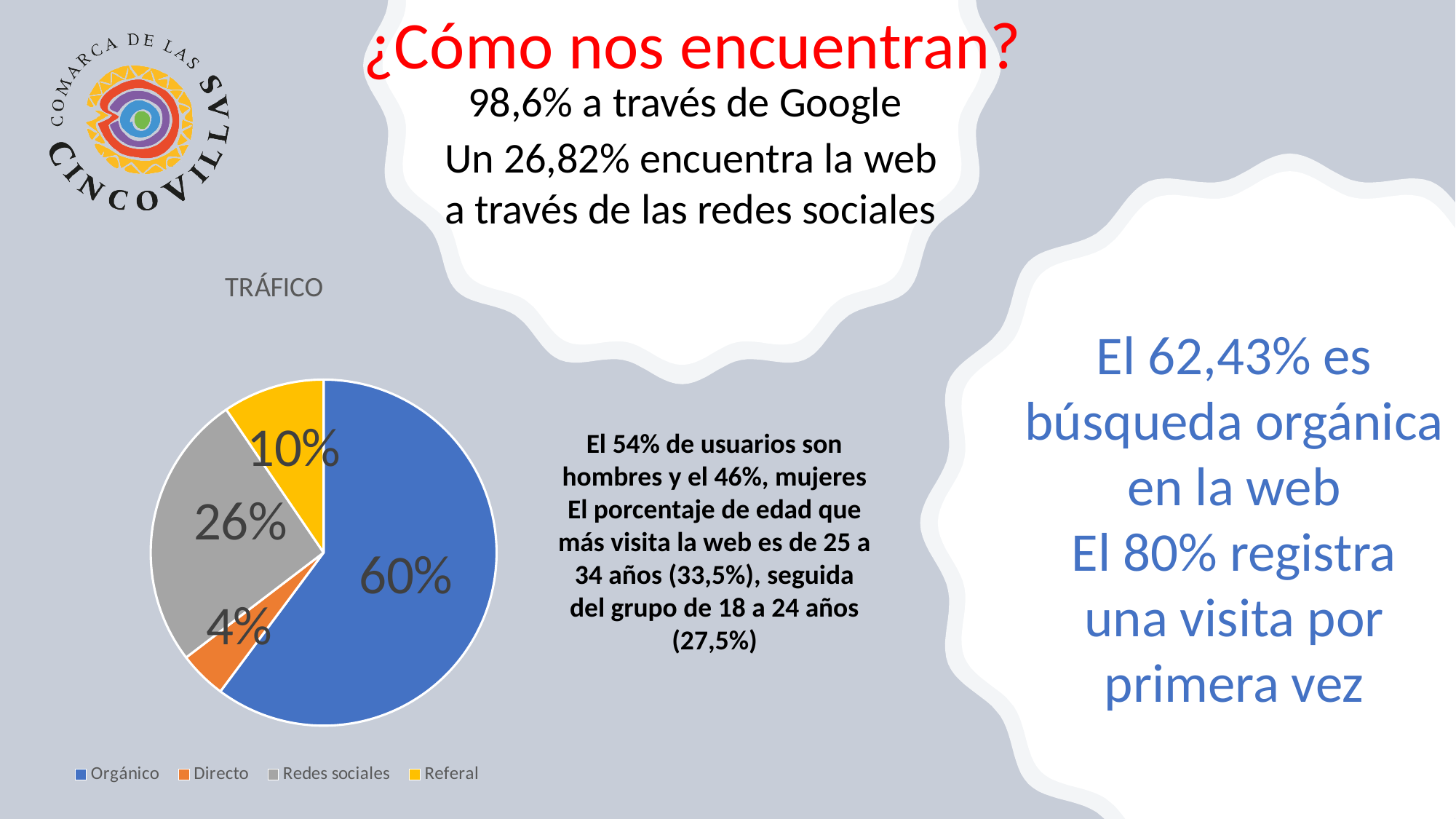
What is the title of the pie chart? TRÁFICO What is the difference between the Orgánico and Redes sociales shares? 34% What kind of chart is the TRÁFICO chart? pie chart What share of the pie does Redes sociales have? 26% Which is larger, the Redes sociales slice or the Referal slice? Redes sociales Which category has the smallest slice of the pie? Directo What share of the pie does Orgánico have? 60% Which category has the largest slice of the pie? Orgánico What share of the pie does Referal have? 10% What share of the pie does Directo have? 4% How many categories does the pie chart show? 4 What colour is the Referal slice in the pie chart? yellow